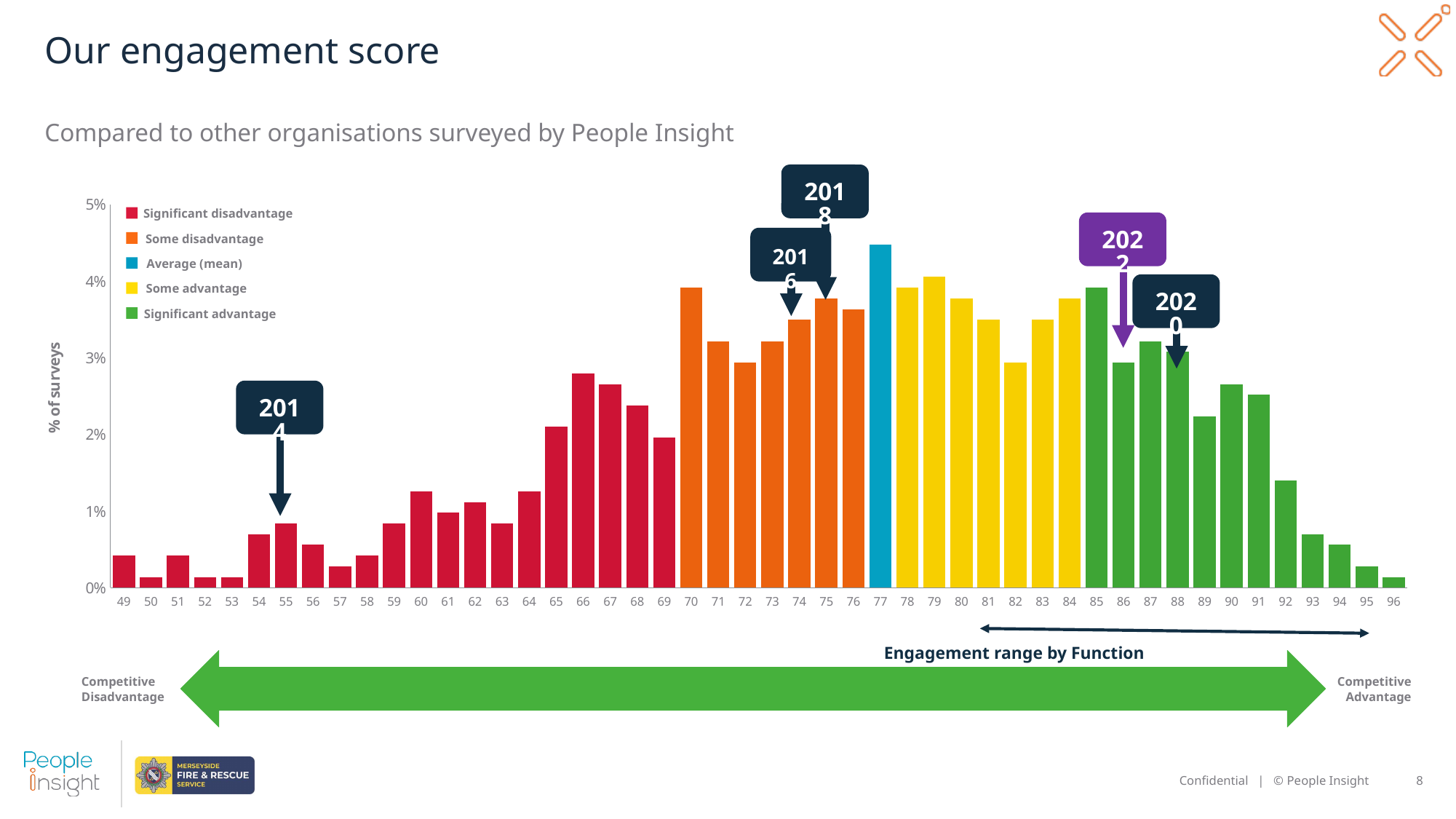
What kind of chart is shown on the slide? bar chart Which engagement score is marked with the 2014 callout? 55 How many entries does the chart legend list? 5 Is the value for score 77 greater or less than 4%? greater Which colour represents 'Average (mean)' in the legend? blue How many engagement score categories are shown along the x axis? 48 Is the value for score 66 greater or less than 3%? less Which has a higher percentage of surveys, score 66 or score 55? 66 Which engagement score has the highest percentage of surveys? 77 Is the value for score 49 greater or less than 1%? less Do the values generally rise or fall along the x axis from score 77 to score 96? fall